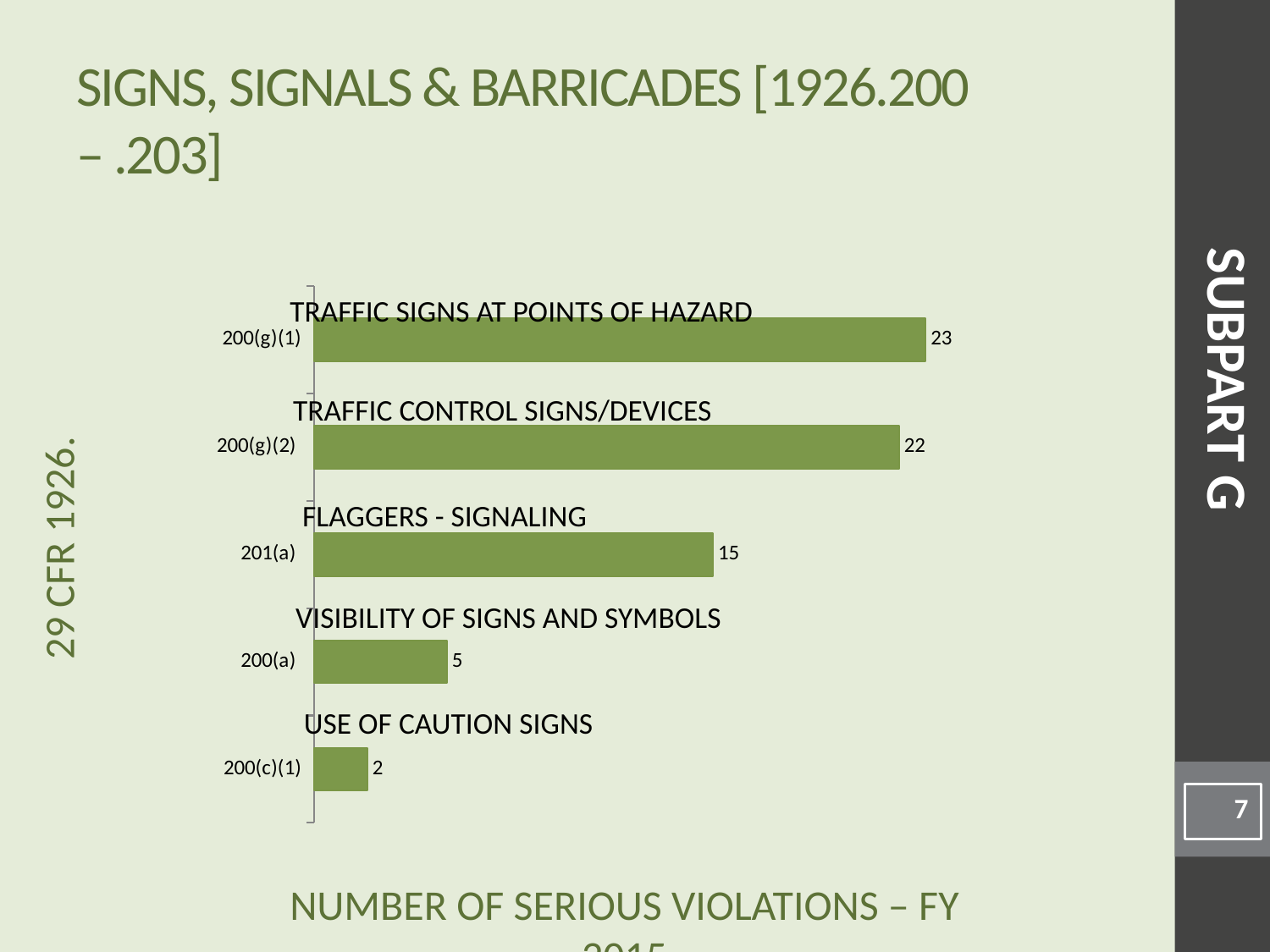
What is the number of serious violations for 201(a), Flaggers - Signaling? 15 Which standard has the highest number of serious violations? 200(g)(1) What is the difference in serious violations between 200(g)(1) and 201(a)? 8 What is the difference in serious violations between 200(a) and 200(c)(1)? 3 What type of chart is shown on the slide? Bar chart What is the number of serious violations for 200(g)(1), Traffic Signs at Points of Hazard? 23 What is the number of serious violations for 200(a), Visibility of Signs and Symbols? 5 Which standard has the lowest number of serious violations? 200(c)(1) How many standards are shown in the chart? 5 What is the number of serious violations for 200(g)(2), Traffic Control Signs/Devices? 22 Which has more serious violations, 201(a) or 200(a)? 201(a) What is the number of serious violations for 200(c)(1), Use of Caution Signs? 2